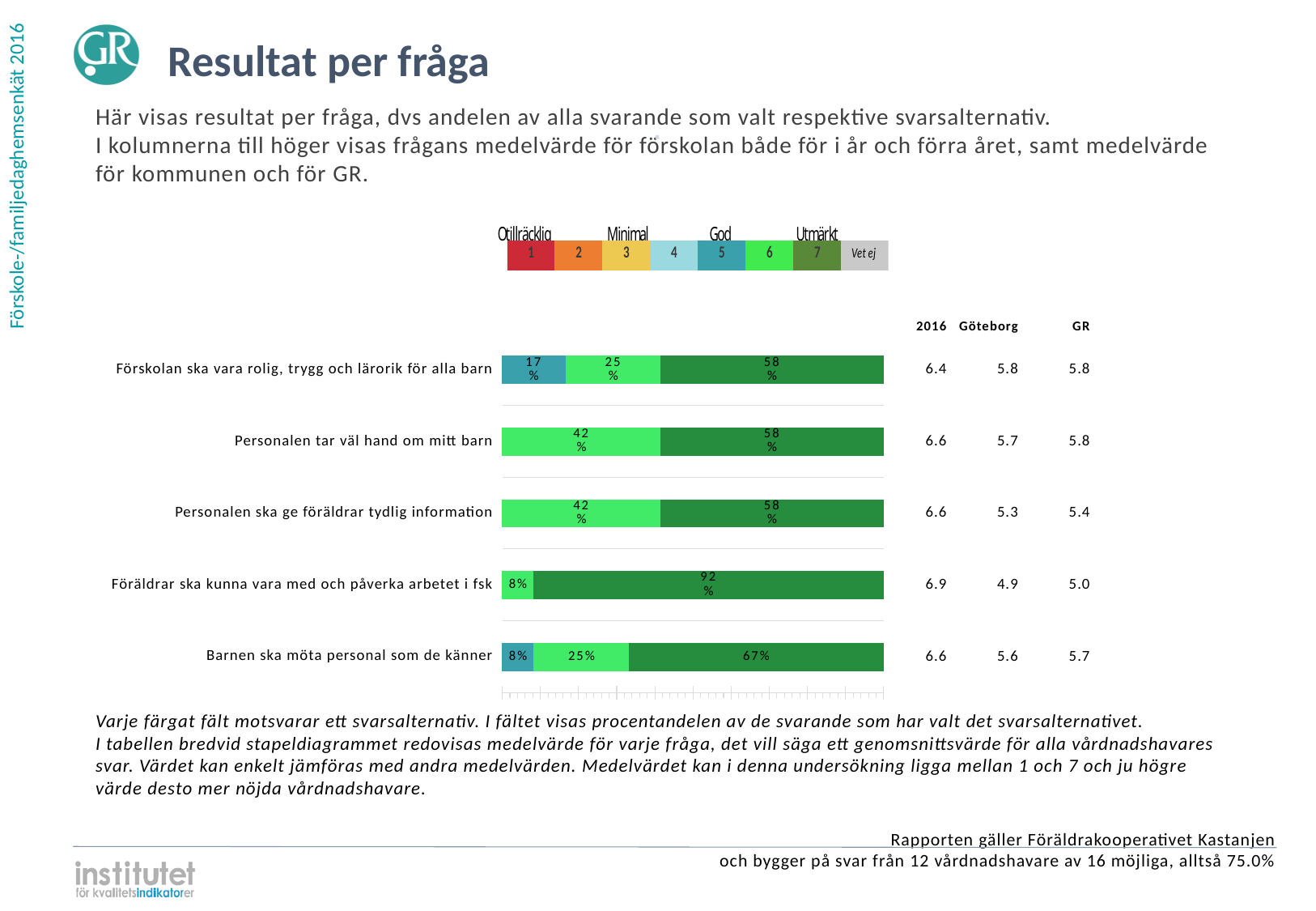
What kind of chart is shown on the slide? Stacked horizontal bar chart For 'Förskolan ska vara rolig, trygg och lärorik för alla barn', what is the difference in percentage points between the share choosing 7 and the share choosing 5? 41 What percentage of respondents chose answer 5 for 'Barnen ska möta personal som de känner'? 8% Which question has the largest share of respondents choosing answer 7? Föräldrar ska kunna vara med och påverka arbetet i fsk Which question has the lowest 2016 mean value? Förskolan ska vara rolig, trygg och lärorik för alla barn What label does the legend give to answer option 7? Utmärkt What is the 2016 mean value for 'Föräldrar ska kunna vara med och påverka arbetet i fsk'? 6.9 What percentage of respondents chose answer 7 for 'Föräldrar ska kunna vara med och påverka arbetet i fsk'? 92% What percentage of respondents chose answer 6 for 'Personalen tar väl hand om mitt barn'? 42% What is the total of the segments in the bar for 'Barnen ska möta personal som de känner'? 100% How many questions (categories) are plotted in the bar chart? 5 For 'Personalen ska ge föräldrar tydlig information', which is higher: the Göteborg mean or the GR mean? GR